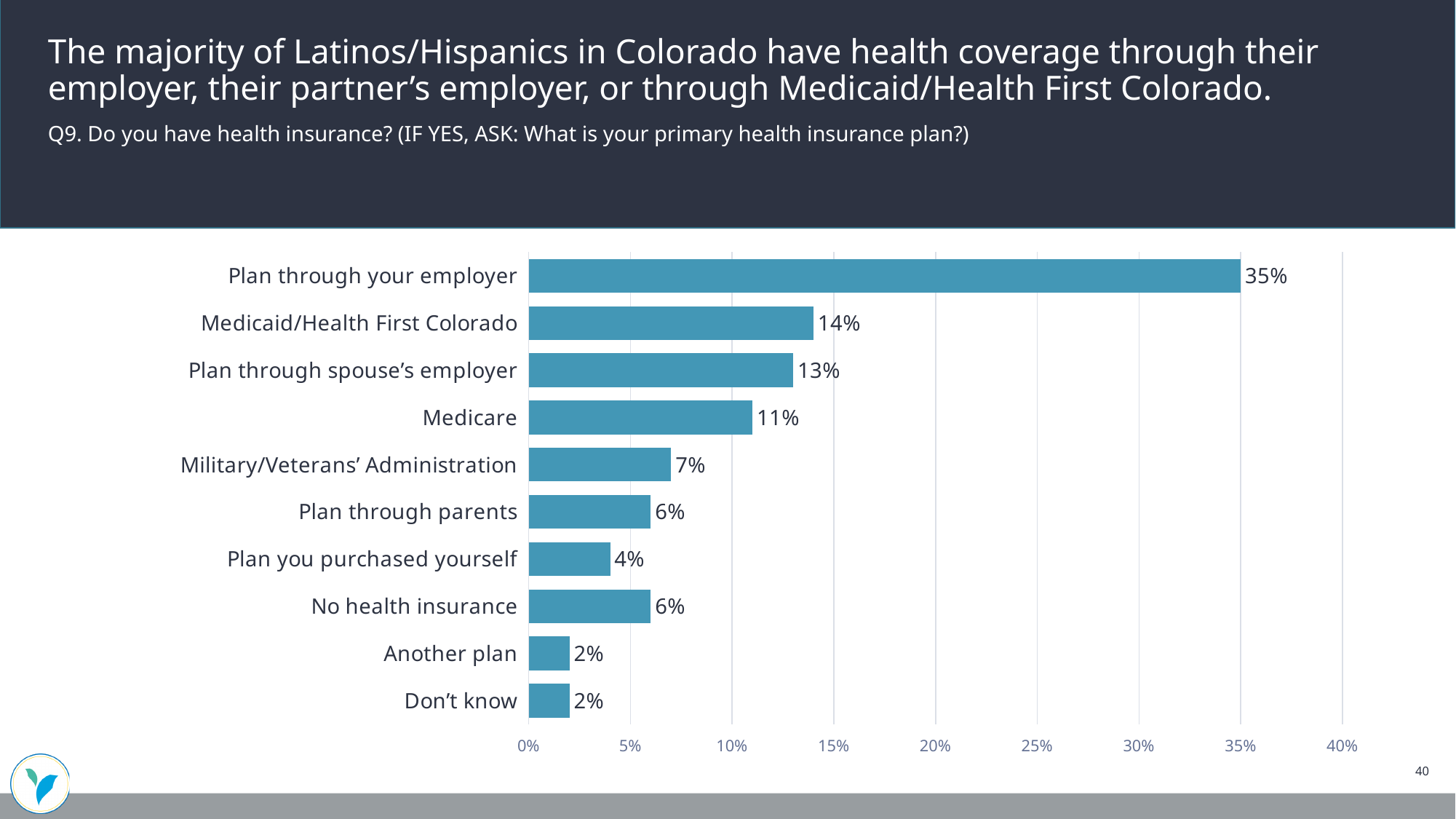
What is the difference between Medicare and Plan through parents? 5% Is the value for Plan through your employer greater or less than 30%? greater What is the difference between the value for Plan through your employer and the value for Medicaid/Health First Colorado? 21% How many categories are shown in the chart? 10 What is the highest value shown on the x axis? 40% What percentage of respondents have no health insurance? 6% What is the value for Military/Veterans' Administration? 7% What percentage of respondents have a plan through their employer? 35% Which is larger, the value for Plan through spouse's employer or the value for Medicare? Plan through spouse's employer What kind of chart is shown on the slide? bar chart What is the value for Medicaid/Health First Colorado? 14% Which category has the highest value? Plan through your employer